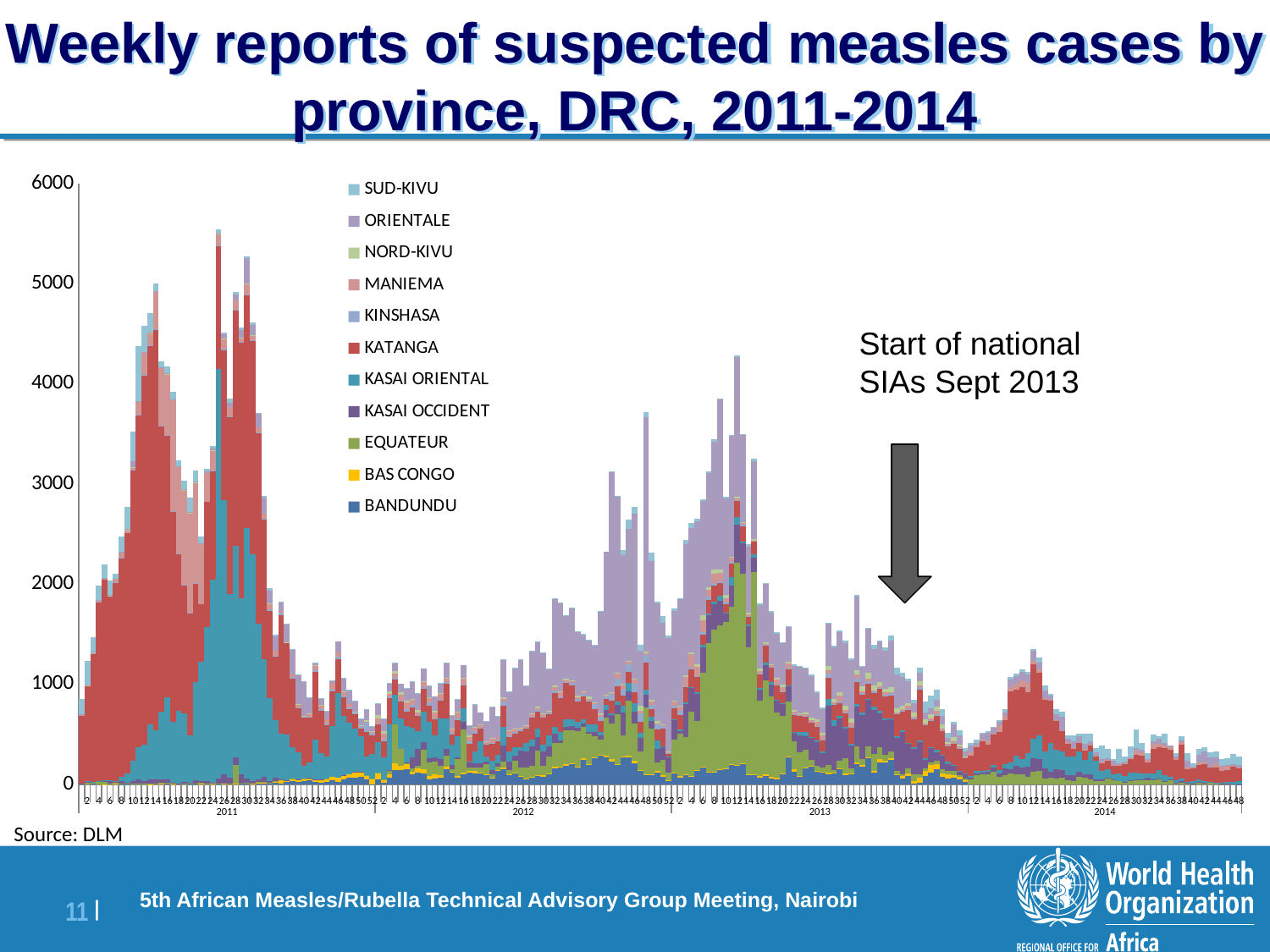
How many provinces (series) does the legend list? 11 According to the annotation on the chart, when did the national SIAs start? Sept 2013 Is the highest weekly total in 2011 greater or less than 5000? greater Are the weekly totals in the second half of 2014 greater or less than 1000? less What is the highest value shown on the y axis of the chart? 6000 Is the highest weekly total in 2013 greater or less than 5000? less What is the title of the chart? Weekly reports of suspected measles cases by province, DRC, 2011-2014 In which year does the chart show the highest weekly total of suspected measles cases? 2011 What kind of chart is shown on the slide? Stacked bar chart Which years are labelled along the x axis of the chart? 2011, 2012, 2013, 2014 Which year has the highest weekly peak: 2011 or 2014? 2011 Overall, do the weekly totals rise or fall from 2011 to the end of 2014? fall